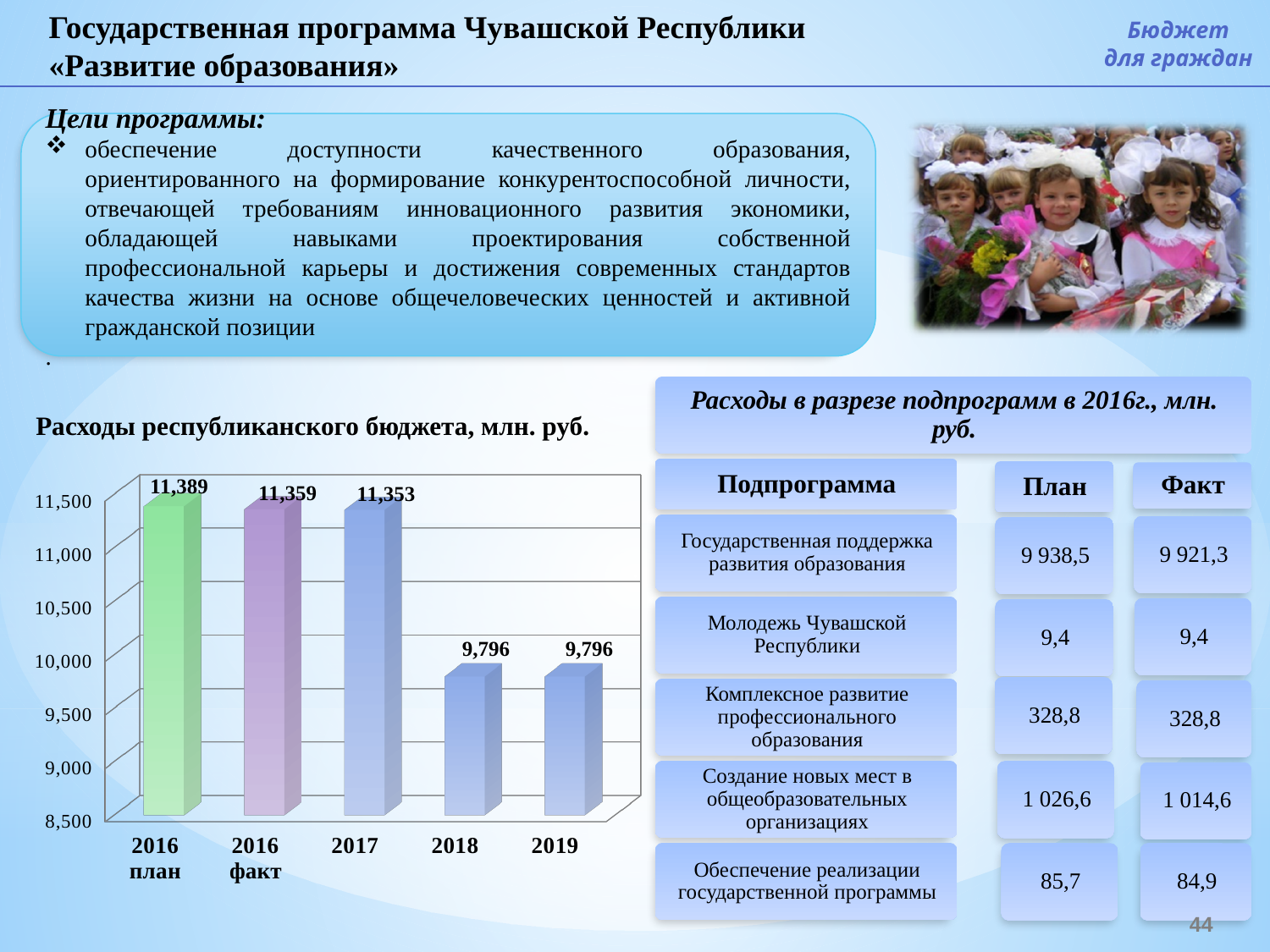
Do the values in the chart 'Расходы республиканского бюджета, млн. руб.' generally rise or fall from 2016 план to 2019? fall Is the value for 2018 greater or less than 10,000 in the chart 'Расходы республиканского бюджета, млн. руб.'? less What is the value for 2016 план in the chart 'Расходы республиканского бюджета, млн. руб.'? 11,389 Which is larger in the chart 'Расходы республиканского бюджета, млн. руб.': the value for 2017 or the value for 2018? 2017 What type of chart is 'Расходы республиканского бюджета, млн. руб.'? bar chart What is the value for 2017 in the chart 'Расходы республиканского бюджета, млн. руб.'? 11,353 Which category has the highest value in the chart 'Расходы республиканского бюджета, млн. руб.'? 2016 план What is the difference between the 2016 план and 2016 факт values in the chart 'Расходы республиканского бюджета, млн. руб.'? 30 What is the difference between the 2017 and 2018 values in the chart 'Расходы республиканского бюджета, млн. руб.'? 1,557 How many bars are shown in the chart 'Расходы республиканского бюджета, млн. руб.'? 5 What is the value for 2016 факт in the chart 'Расходы республиканского бюджета, млн. руб.'? 11,359 What is the value for 2019 in the chart 'Расходы республиканского бюджета, млн. руб.'? 9,796